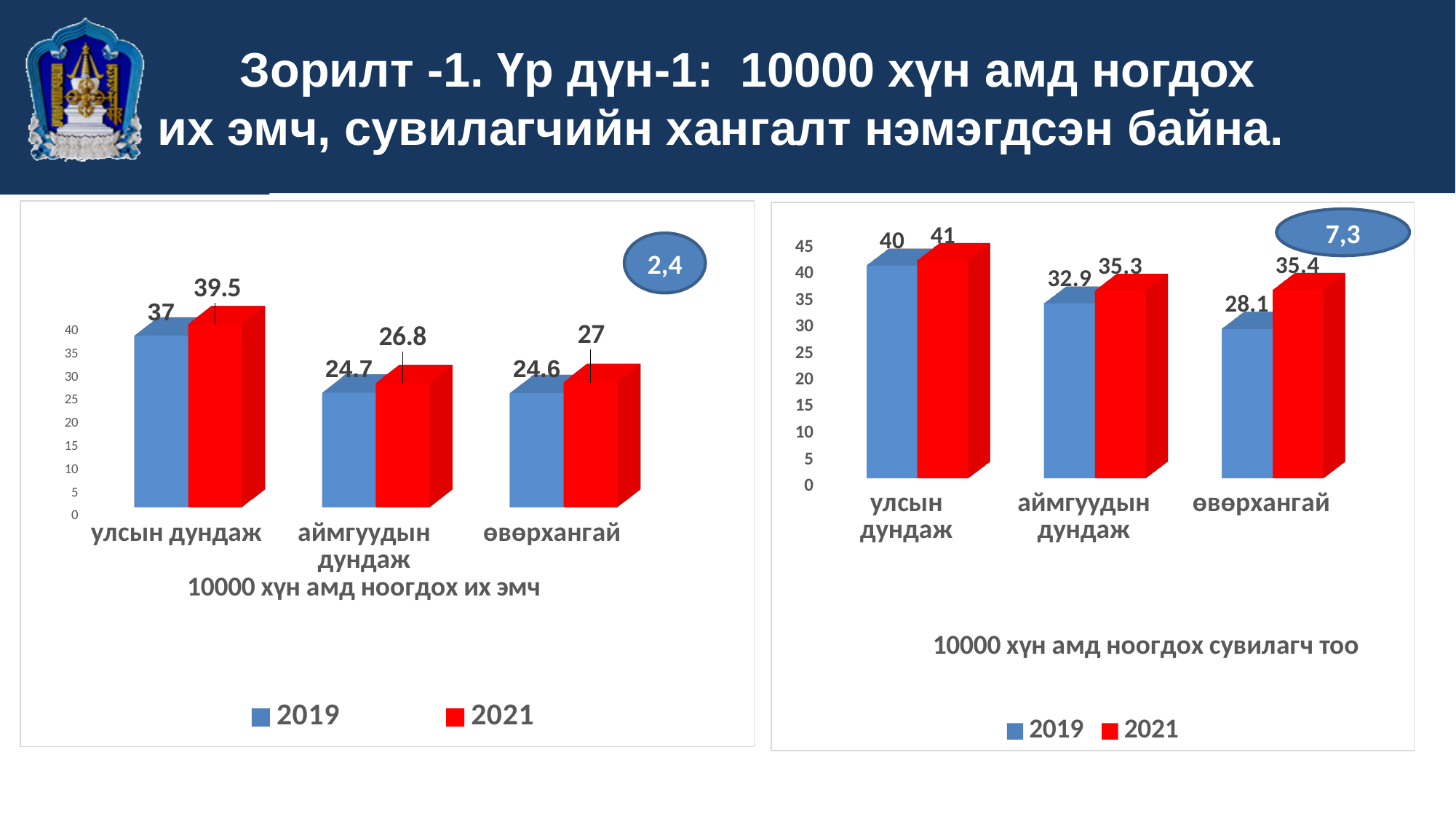
In the right chart (10000 хүн амд ноогдох сувилагч тоо), which category has the lowest 2019 value? өвөрхангай In the left chart (10000 хүн амд ноогдох их эмч), what is the 2021 value for улсын дундаж? 39.5 What type of chart is the right chart (10000 хүн амд ноогдох сувилагч тоо)? Bar chart In the right chart (10000 хүн амд ноогдох сувилагч тоо), what is the 2021 value for аймгуудын дундаж? 35.3 In the right chart (10000 хүн амд ноогдох сувилагч тоо), what is the difference between the 2021 and 2019 values for өвөрхангай? 7.3 In the left chart (10000 хүн амд ноогдох их эмч), what is the difference between the 2021 and 2019 values for улсын дундаж? 2.5 In the left chart (10000 хүн амд ноогдох их эмч), which category has the highest 2021 value? улсын дундаж In the right chart (10000 хүн амд ноогдох сувилагч тоо), what is the 2019 value for өвөрхангай? 28.1 In the left chart (10000 хүн амд ноогдох их эмч), which is larger for өвөрхангай: the 2019 value or the 2021 value? 2021 How many series does the legend of the left chart (10000 хүн амд ноогдох их эмч) list? 2 How many categories are shown on the x axis of the right chart (10000 хүн амд ноогдох сувилагч тоо)? 3 In the left chart (10000 хүн амд ноогдох их эмч), what is the 2019 value for өвөрхангай? 24.6